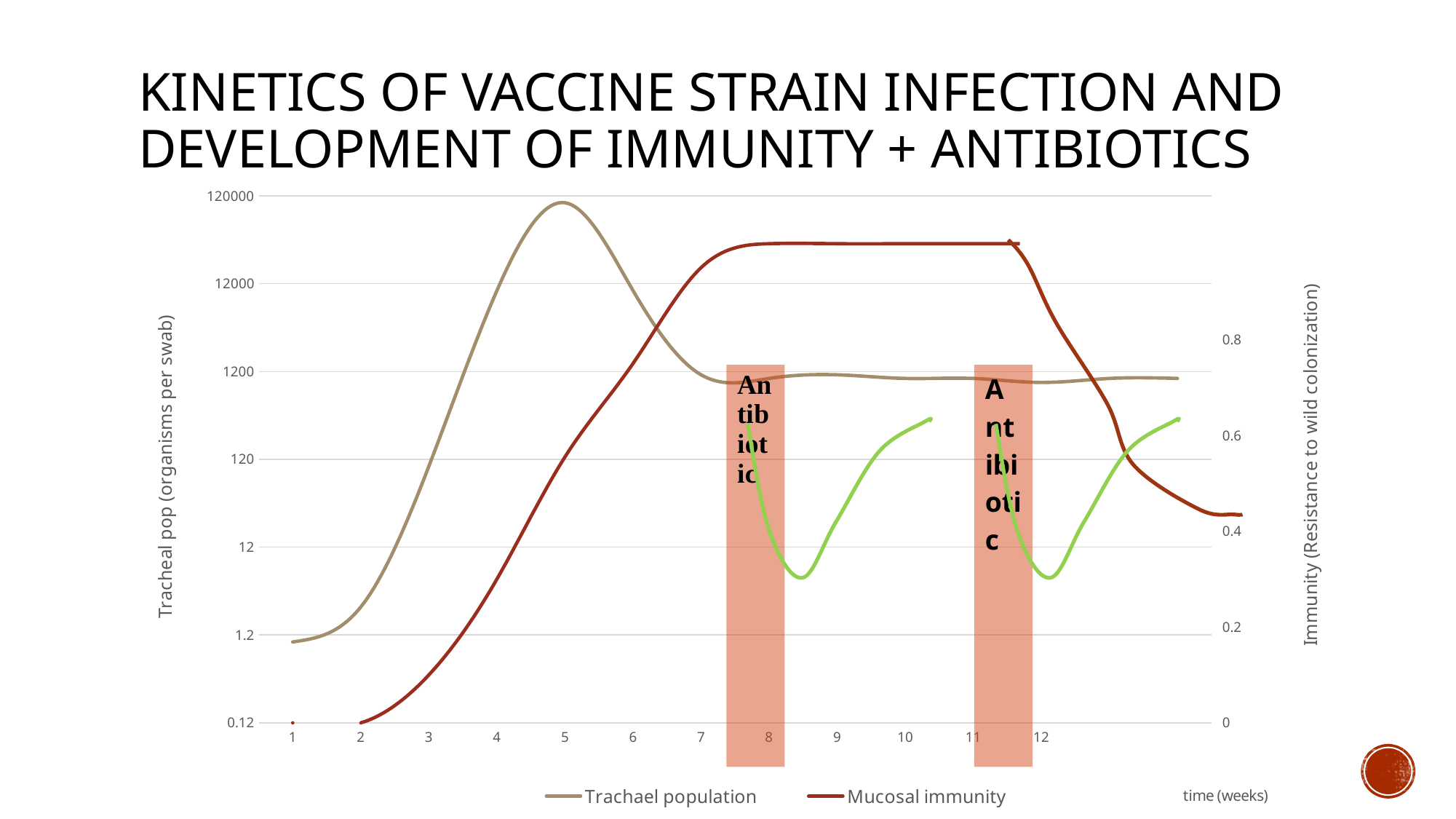
Does the Trachael population line rise or fall between week 5 and week 7? fall Is the Trachael population at week 5 greater or less than 12000? greater Is the Mucosal immunity value at week 9 greater or less than 0.8? greater How many labeled week ticks are on the x axis? 12 How many series does the legend list? 2 At which week does the Trachael population reach its highest value? 5 Does the Mucosal immunity line rise or fall between week 2 and week 8? rise What kind of chart is shown on the slide? line chart What is the title of the left vertical axis? Tracheal pop (organisms per swab) What is the title of the right vertical axis? Immunity (Resistance to wild colonization) Which is higher for the Trachael population: the value at week 5 or the value at week 8? week 5 Is the Mucosal immunity value at week 2 greater or less than 0.2? less